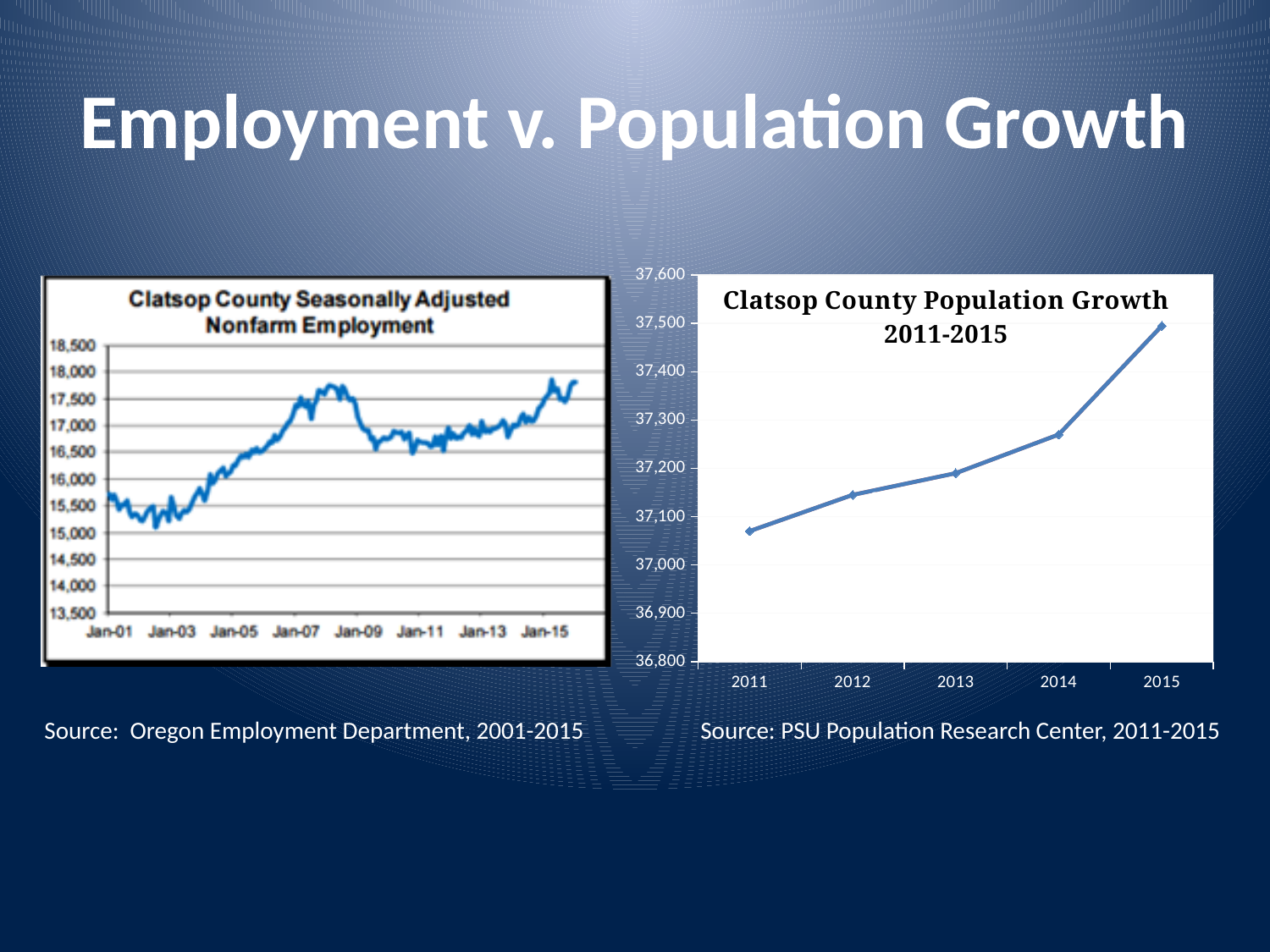
In the Clatsop County Population Growth 2011-2015 chart, which year has the lowest population? 2011 In the Clatsop County Population Growth 2011-2015 chart, which year has the highest population? 2015 What kind of chart is the Clatsop County Seasonally Adjusted Nonfarm Employment chart on the left? line chart In the Clatsop County Population Growth 2011-2015 chart, how many years are plotted on the x axis? 5 What kind of chart is the Clatsop County Population Growth 2011-2015 chart on the right? line chart In the Clatsop County Population Growth 2011-2015 chart, is the value for 2015 greater or less than 37,400? greater In the Clatsop County Population Growth 2011-2015 chart, which is larger, the value for 2013 or the value for 2015? 2015 In the Clatsop County Seasonally Adjusted Nonfarm Employment chart, is the value at Jan-15 greater or less than 17,000? greater In the Clatsop County Population Growth 2011-2015 chart, is the value for 2014 greater or less than 37,200? greater What is the source cited for the Clatsop County Population Growth 2011-2015 chart? PSU Population Research Center, 2011-2015 In the Clatsop County Population Growth 2011-2015 chart, do the values rise or fall from 2011 to 2015? rise